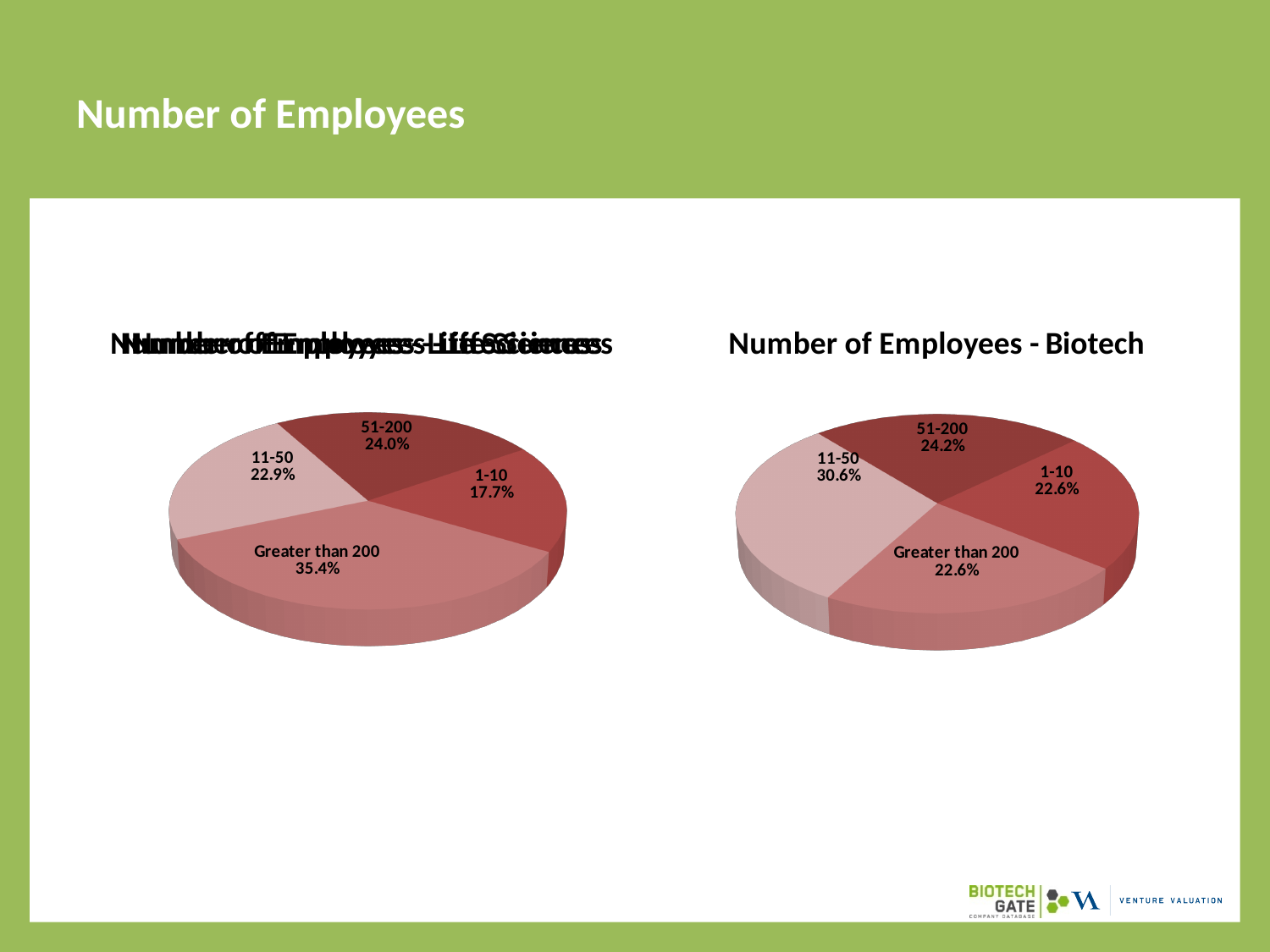
In the left pie chart, what share do companies with greater than 200 employees have? 35.4% In the 'Number of Employees - Biotech' chart, which employee category has the largest share? 11-50 In the 'Number of Employees - Biotech' chart, what share do companies with 11-50 employees have? 30.6% How many slices does the 'Number of Employees - Biotech' chart have? 4 In the 'Number of Employees - Biotech' chart, what share do companies with 51-200 employees have? 24.2% In the left pie chart, what is the difference between the share for 'Greater than 200' and the share for '1-10'? 17.7% In the left pie chart, which is larger: the share for '51-200' or the share for '11-50'? 51-200 In the left pie chart, what share do companies with 1-10 employees have? 17.7% What type of chart is the 'Number of Employees - Biotech' chart? Pie chart In the left pie chart, which employee category has the largest share? Greater than 200 In the 'Number of Employees - Biotech' chart, what is the difference between the share for '11-50' and the share for '51-200'? 6.4% In the left pie chart, which employee category has the smallest share? 1-10